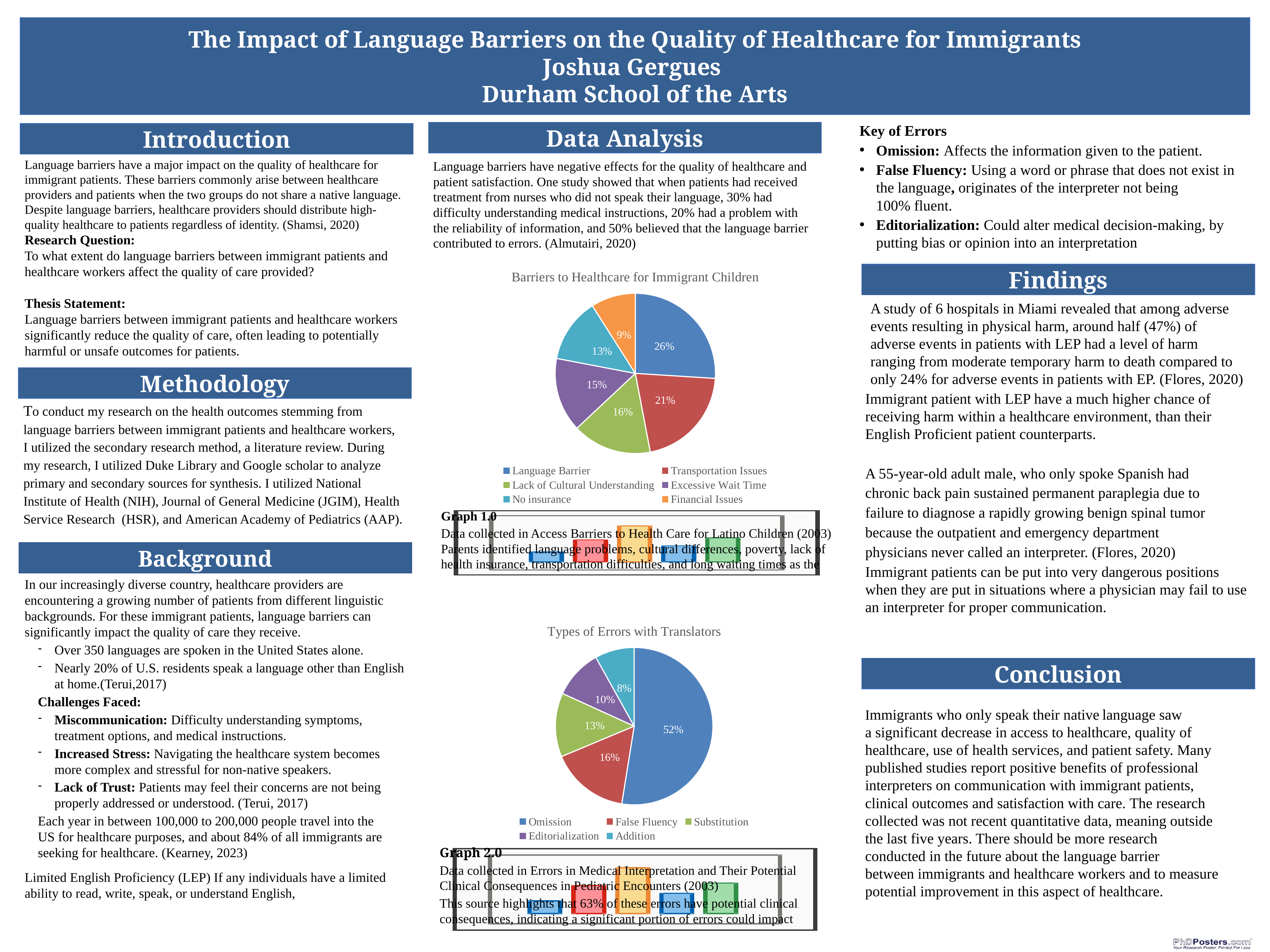
What kind of chart is 'Types of Errors with Translators'? Pie chart In the 'Barriers to Healthcare for Immigrant Children' chart, what share is labelled for Transportation Issues? 21% In the 'Types of Errors with Translators' chart, what share is labelled for Omission? 52% In the 'Barriers to Healthcare for Immigrant Children' chart, which category has the largest slice? Language Barrier In the 'Types of Errors with Translators' chart, which category has the smallest slice? Addition In the 'Types of Errors with Translators' chart, how many categories does the legend list? 5 In the 'Barriers to Healthcare for Immigrant Children' chart, how many categories does the legend list? 6 In the 'Types of Errors with Translators' chart, what share is labelled for Editorialization? 10% In the 'Barriers to Healthcare for Immigrant Children' chart, which category has the smallest slice? Financial Issues In the 'Barriers to Healthcare for Immigrant Children' chart, what share is labelled for Language Barrier? 26% In the 'Types of Errors with Translators' chart, which is larger, False Fluency or Substitution? False Fluency In the 'Barriers to Healthcare for Immigrant Children' chart, what is the difference in percentage points between Lack of Cultural Understanding and No insurance? 3